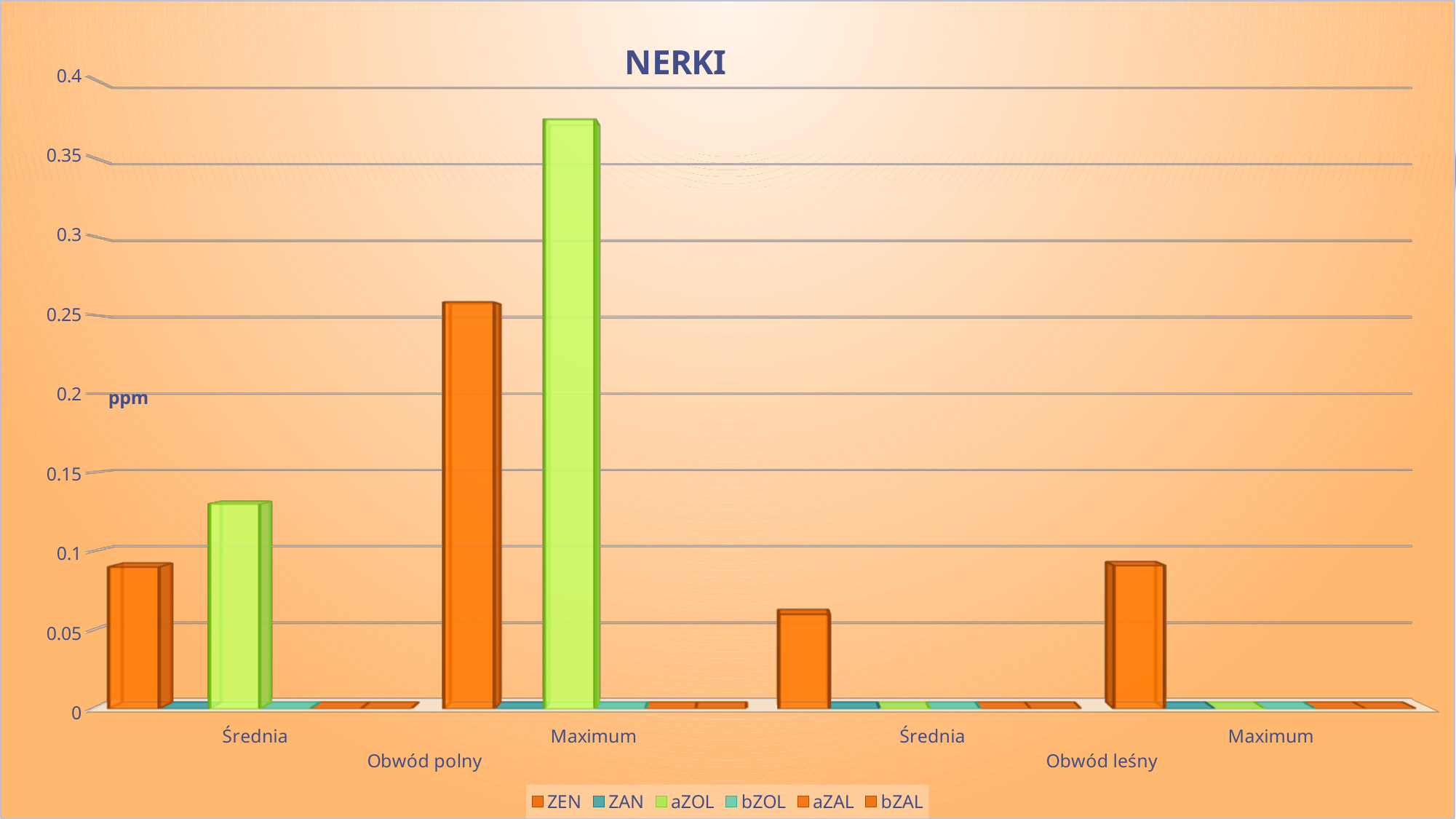
Is the aZOL value for Średnia in Obwód polny greater or less than 0.1? greater How many series does the legend list? 6 Is the ZEN value for Maximum in Obwód leśny greater or less than 0.1? less Which has the larger ZEN value for Średnia: Obwód polny or Obwód leśny? Obwód polny Is the ZEN value for Średnia in Obwód leśny greater or less than 0.05? greater Which series has the tallest bar in the whole chart? aZOL What is the title of the chart? NERKI What type of chart is shown on the slide? bar chart How many category groups (Średnia/Maximum) are shown along the x axis? 4 For Maximum in Obwód polny, which is larger: ZEN or aZOL? aZOL